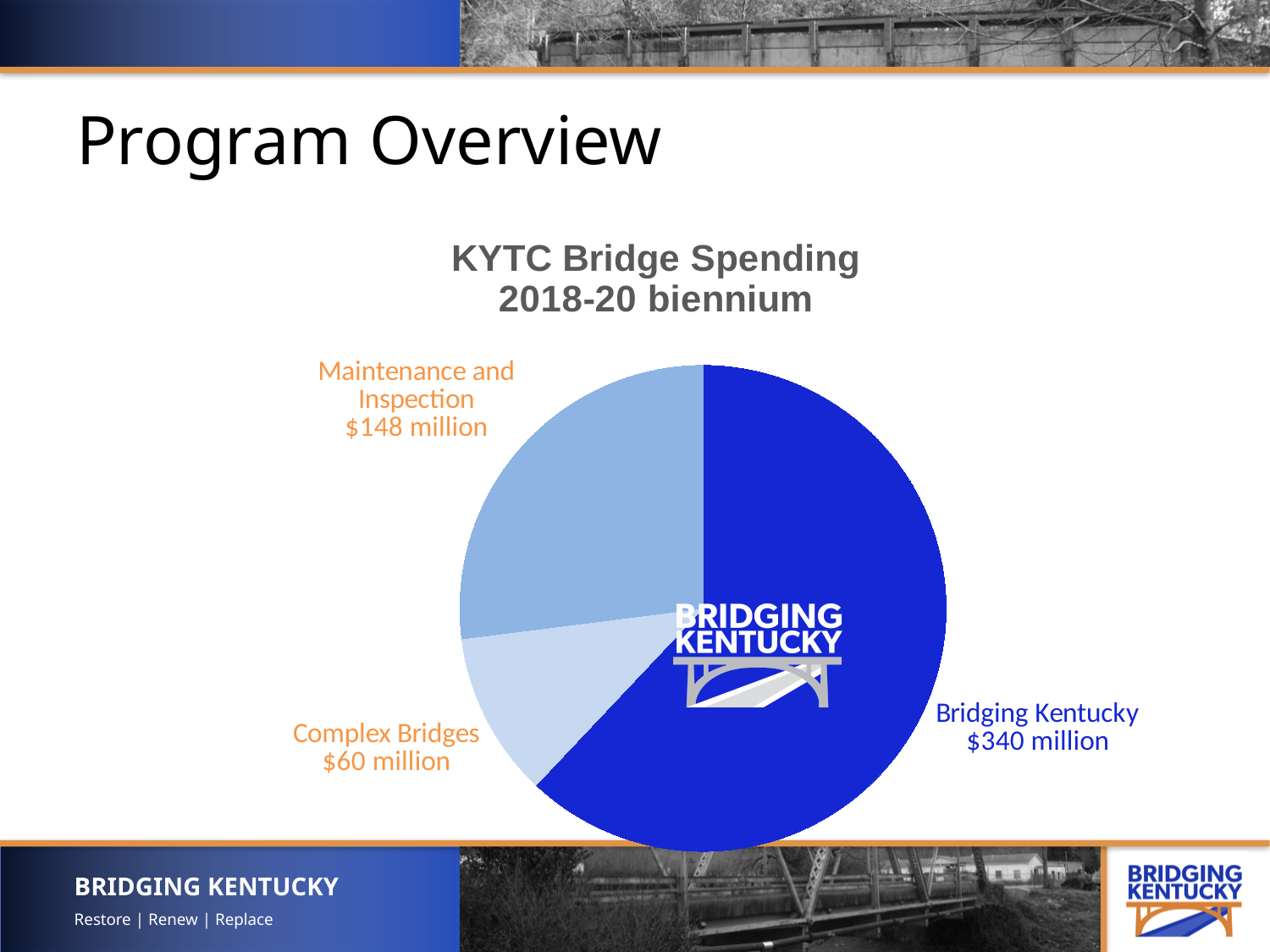
How many slices does the pie chart have? 3 What is the spending value for Maintenance and Inspection? $148 million What is the total KYTC bridge spending shown across all three slices? $548 million What is the spending value for Complex Bridges? $60 million Which category has the smallest share of KYTC bridge spending? Complex Bridges What is the title of the chart? KYTC Bridge Spending 2018-20 biennium Which is larger, the spending on Maintenance and Inspection or on Complex Bridges? Maintenance and Inspection What is the spending value for Bridging Kentucky? $340 million How much more is spent on Maintenance and Inspection than on Complex Bridges? $88 million How much more is spent on Bridging Kentucky than on Maintenance and Inspection? $192 million What kind of chart is shown on the slide? Pie chart Which category has the largest share of KYTC bridge spending? Bridging Kentucky